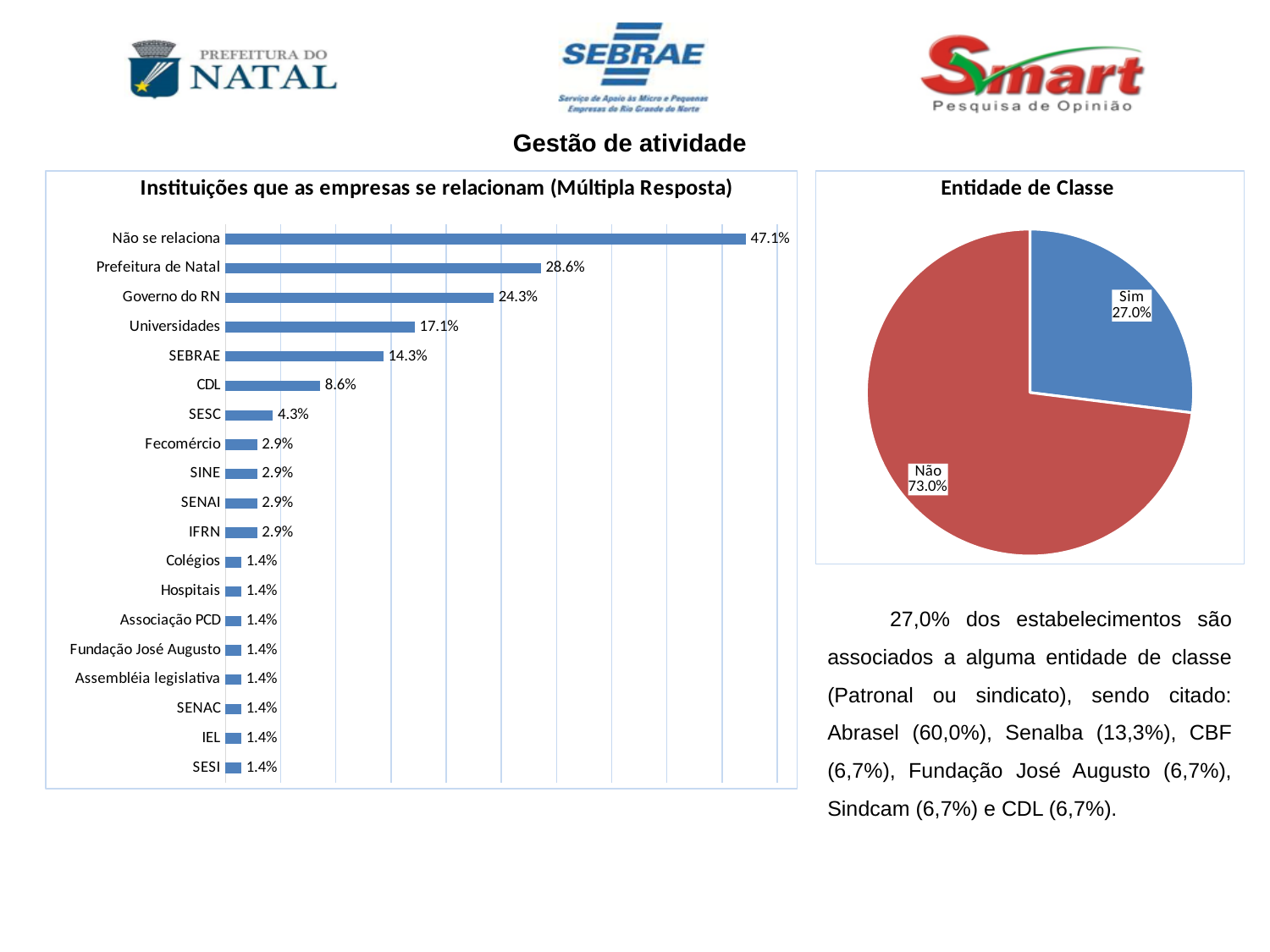
What type of chart is 'Entidade de Classe'? Pie chart In the pie chart 'Entidade de Classe', which slice is larger, Sim or Não? Não In the chart 'Instituições que as empresas se relacionam (Múltipla Resposta)', which is larger, SESC or Fecomércio? SESC In the pie chart 'Entidade de Classe', what is the value for Não? 73.0% How many categories are shown in the chart 'Instituições que as empresas se relacionam (Múltipla Resposta)'? 19 In the chart 'Instituições que as empresas se relacionam (Múltipla Resposta)', what is the difference between Governo do RN and Universidades? 7.2% In the chart 'Instituições que as empresas se relacionam (Múltipla Resposta)', what is the value for CDL? 8.6% In the chart 'Instituições que as empresas se relacionam (Múltipla Resposta)', what is the value for Prefeitura de Natal? 28.6% In the chart 'Instituições que as empresas se relacionam (Múltipla Resposta)', which category has the highest value? Não se relaciona What type of chart is 'Instituições que as empresas se relacionam (Múltipla Resposta)'? Bar chart In the chart 'Instituições que as empresas se relacionam (Múltipla Resposta)', what is the value for SEBRAE? 14.3% In the pie chart 'Entidade de Classe', what is the share for Sim? 27.0%